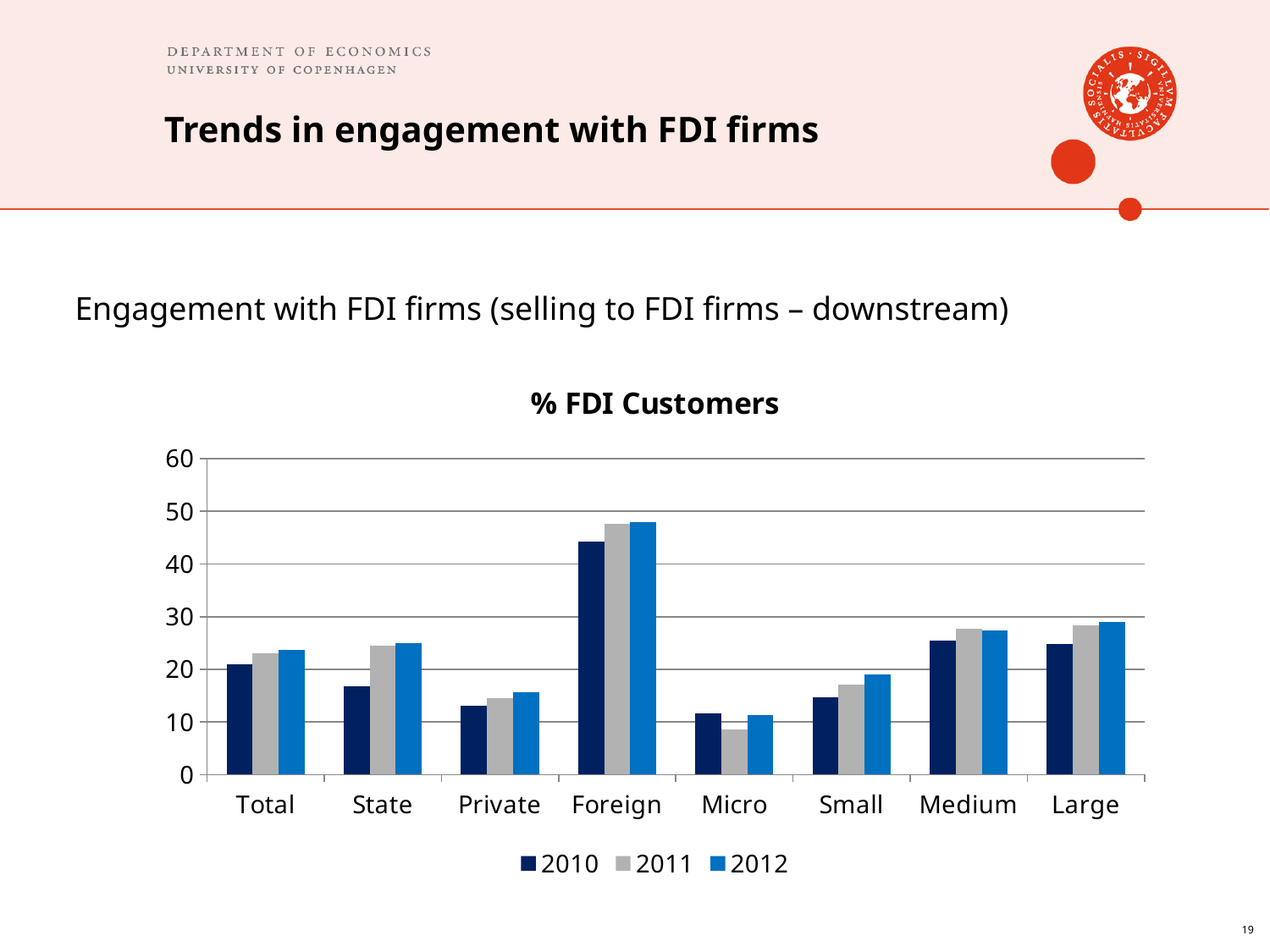
Which is larger for 2010: State or Private? State What kind of chart is shown on the slide? bar chart Which is larger for 2012: Foreign or Large? Foreign Do the values for Small rise or fall from 2010 to 2012? rise What is the title of the chart? % FDI Customers How many series does the legend list? 3 Is the value for Total in 2012 greater or less than 20? greater Which category has the lowest value for 2011? Micro How many categories are shown on the x axis? 8 Which category has the highest value for 2012? Foreign Is the value for Micro in 2011 greater or less than 10? less Is the value for Foreign in 2010 greater or less than 40? greater